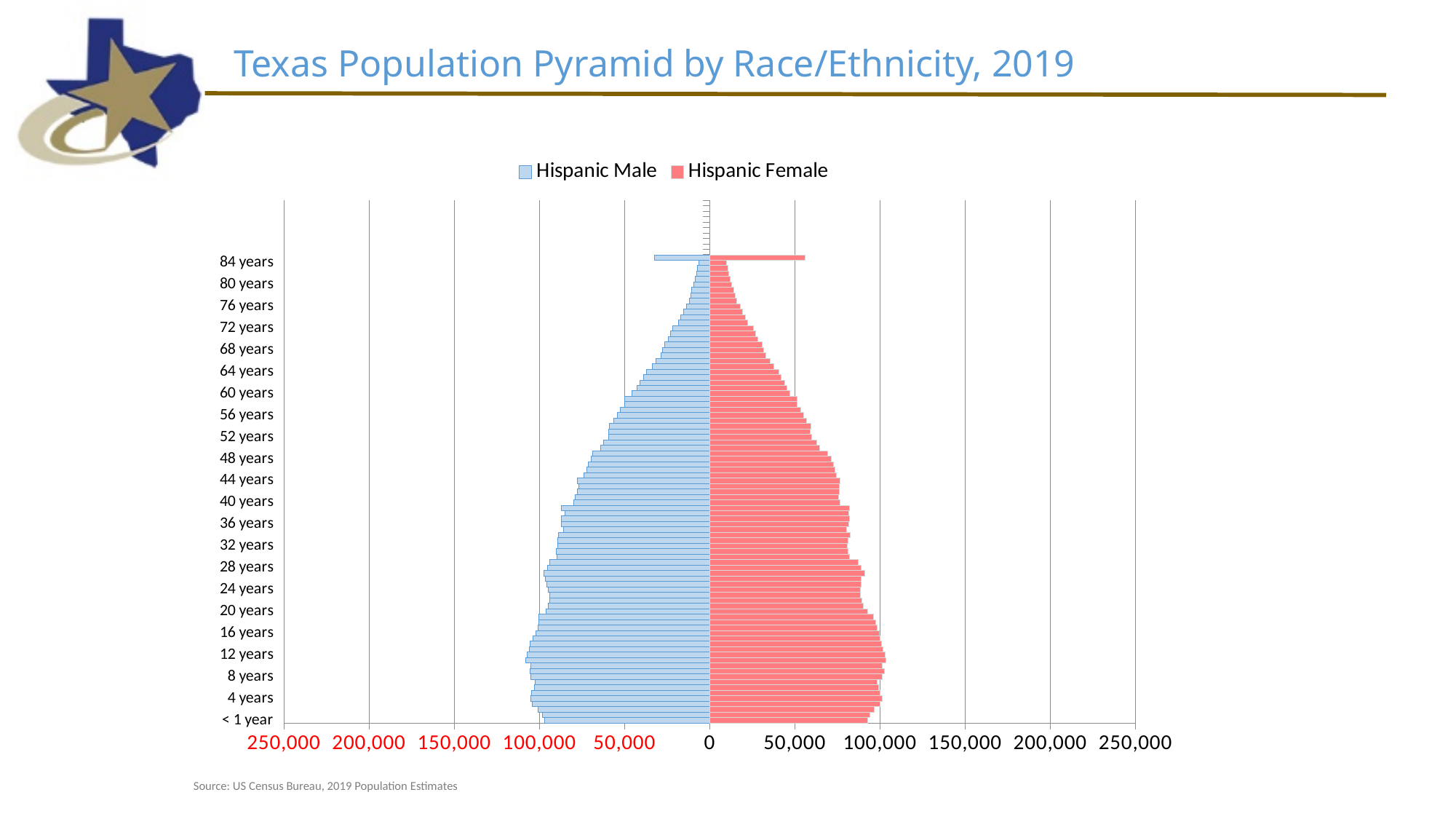
Is the value for Hispanic Male at 12 years greater or less than 100,000? greater How many series does the legend list? 2 Is the value for Hispanic Male at 84 years greater or less than 50,000? less What kind of chart is shown on the slide? Bar chart (population pyramid) Is the value for Hispanic Female at 40 years greater or less than 100,000? less Moving from 84 years down to 12 years, do the Hispanic Male bars generally get longer or shorter? longer At 84 years, which is larger, the Hispanic Male value or the Hispanic Female value? Hispanic Female Which colour represents Hispanic Female in the chart? Red/pink How many age labels are shown on the vertical axis? 22 What are the two series named in the legend? Hispanic Male and Hispanic Female